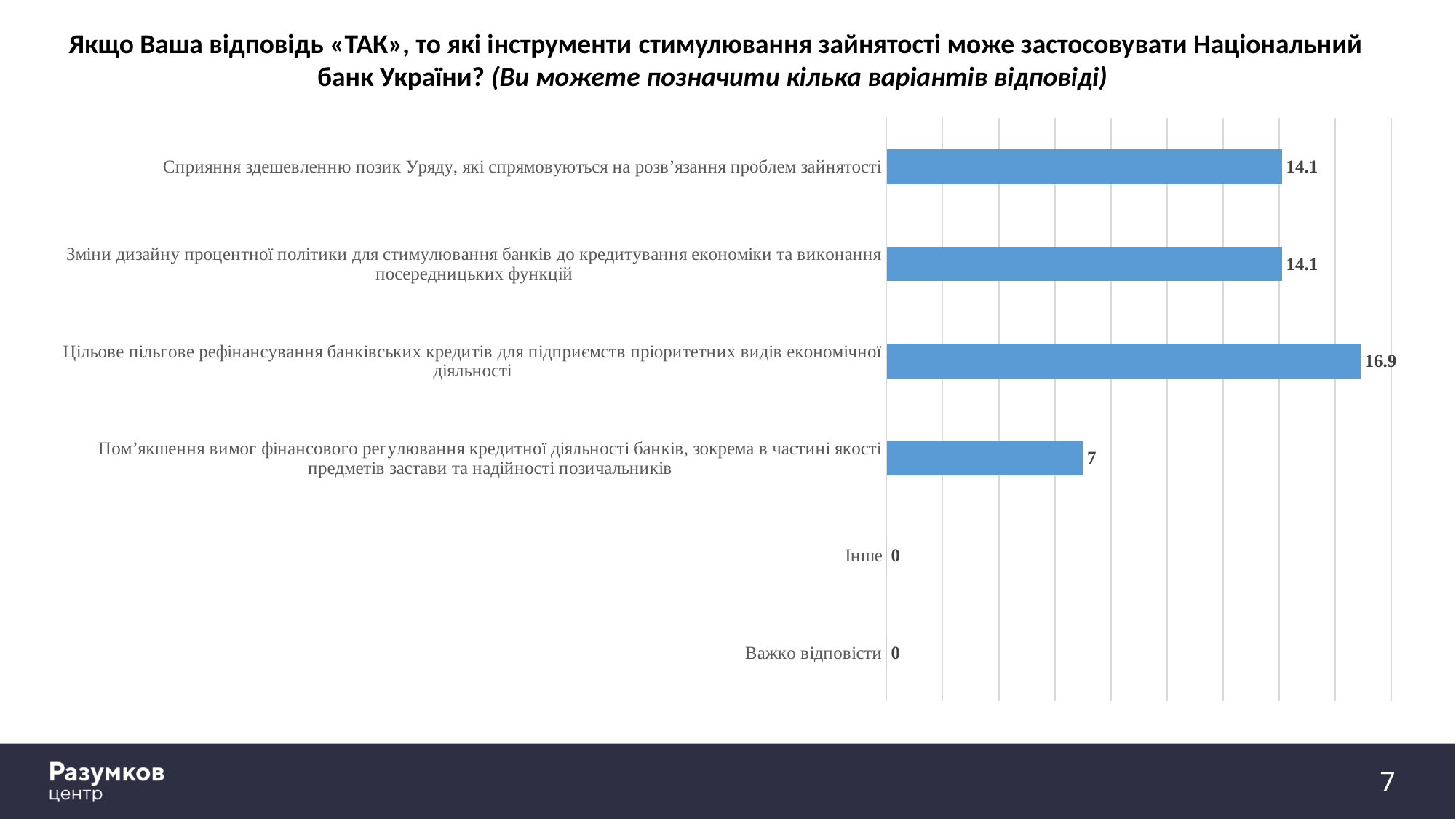
Which is larger: the value for «Зміни дизайну процентної політики для стимулювання банків до кредитування економіки та виконання посередницьких функцій» or the value for «Пом’якшення вимог фінансового регулювання кредитної діяльності банків, зокрема в частині якості предметів застави та надійності позичальників»? Зміни дизайну процентної політики для стимулювання банків до кредитування економіки та виконання посередницьких функцій What is the difference between the value for «Цільове пільгове рефінансування банківських кредитів для підприємств пріоритетних видів економічної діяльності» and the value for «Пом’якшення вимог фінансового регулювання кредитної діяльності банків, зокрема в частині якості предметів застави та надійності позичальників»? 9.9 What kind of chart is shown on the slide? Bar chart What is the value for «Сприяння здешевленню позик Уряду, які спрямовуються на розв’язання проблем зайнятості»? 14.1 What is the value for «Важко відповісти»? 0 Which category has the highest value? Цільове пільгове рефінансування банківських кредитів для підприємств пріоритетних видів економічної діяльності What is the value for «Пом’якшення вимог фінансового регулювання кредитної діяльності банків, зокрема в частині якості предметів застави та надійності позичальників»? 7 How many categories are shown in the chart? 6 What is the difference between the value for «Цільове пільгове рефінансування банківських кредитів для підприємств пріоритетних видів економічної діяльності» and the value for «Зміни дизайну процентної політики для стимулювання банків до кредитування економіки та виконання посередницьких функцій»? 2.8 What is the value for «Цільове пільгове рефінансування банківських кредитів для підприємств пріоритетних видів економічної діяльності»? 16.9 What is the value for «Інше»? 0 How many categories have a value of 0? 2